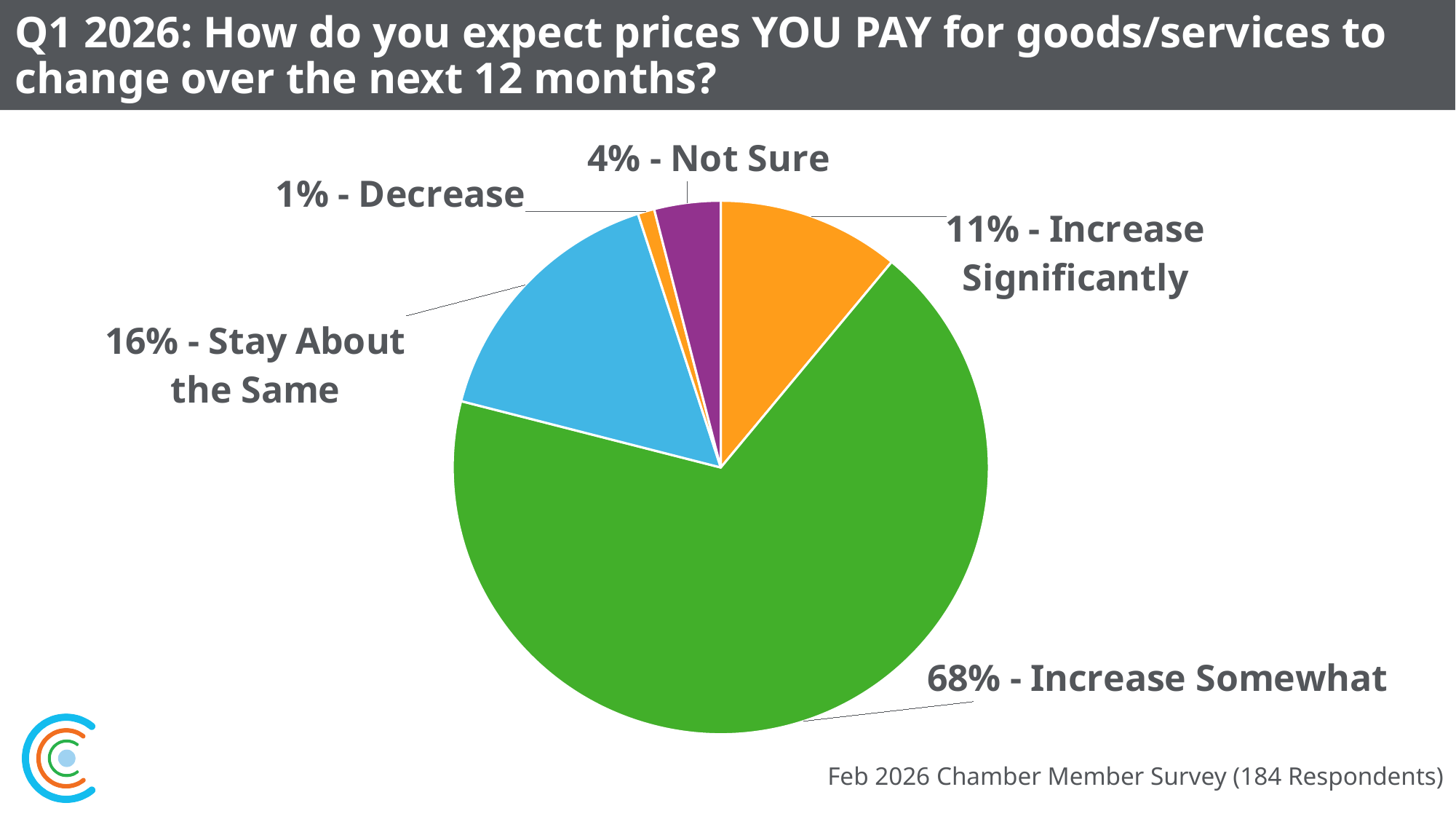
Which response has the smallest slice of the pie? Decrease What kind of chart is shown on the slide? pie chart What share of respondents expect prices to Increase Significantly? 11% Which response has the largest slice of the pie? Increase Somewhat What share of respondents expect prices to Increase Somewhat? 68% What share of respondents answered Not Sure? 4% What colour is the Increase Somewhat slice? green How many slices does the pie chart have? 5 Which is larger: the share for Increase Significantly or the share for Not Sure? Increase Significantly What is the difference in percentage points between Increase Somewhat and Stay About the Same? 52